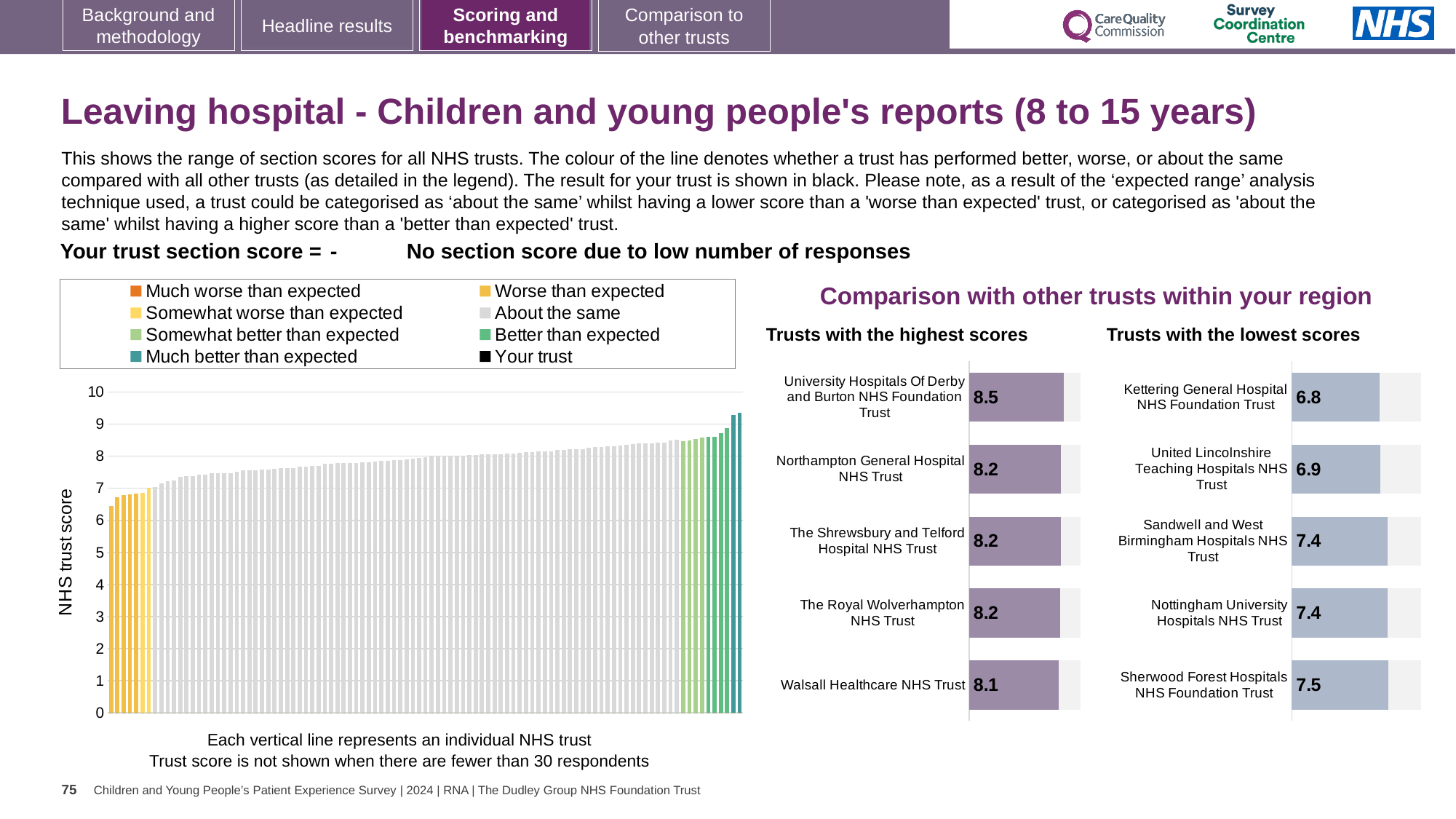
In the 'Trusts with the highest scores' chart, how many trusts are listed? 5 In the 'Trusts with the lowest scores' chart, which trust has the lowest score? Kettering General Hospital NHS Foundation Trust In the large chart on the left showing NHS trust scores, do the values rise or fall from left to right? rise In the 'Trusts with the lowest scores' chart, which has the larger score: Kettering General Hospital NHS Foundation Trust or Sherwood Forest Hospitals NHS Foundation Trust? Sherwood Forest Hospitals NHS Foundation Trust In the 'Trusts with the highest scores' chart, what is the difference between the scores of University Hospitals Of Derby and Burton NHS Foundation Trust and Walsall Healthcare NHS Trust? 0.4 In the 'Trusts with the highest scores' chart, what is the score for University Hospitals Of Derby and Burton NHS Foundation Trust? 8.5 In the 'Trusts with the highest scores' chart, which trust has the highest score? University Hospitals Of Derby and Burton NHS Foundation Trust In the 'Trusts with the lowest scores' chart, what is the score for Kettering General Hospital NHS Foundation Trust? 6.8 In the 'Trusts with the lowest scores' chart, what is the score for Sherwood Forest Hospitals NHS Foundation Trust? 7.5 In the large chart on the left showing NHS trust scores, is the value of the leftmost bar greater or less than 7? less How many entries does the legend above the large chart on the left list? 8 What kind of chart is the large chart on the left showing NHS trust scores? bar chart